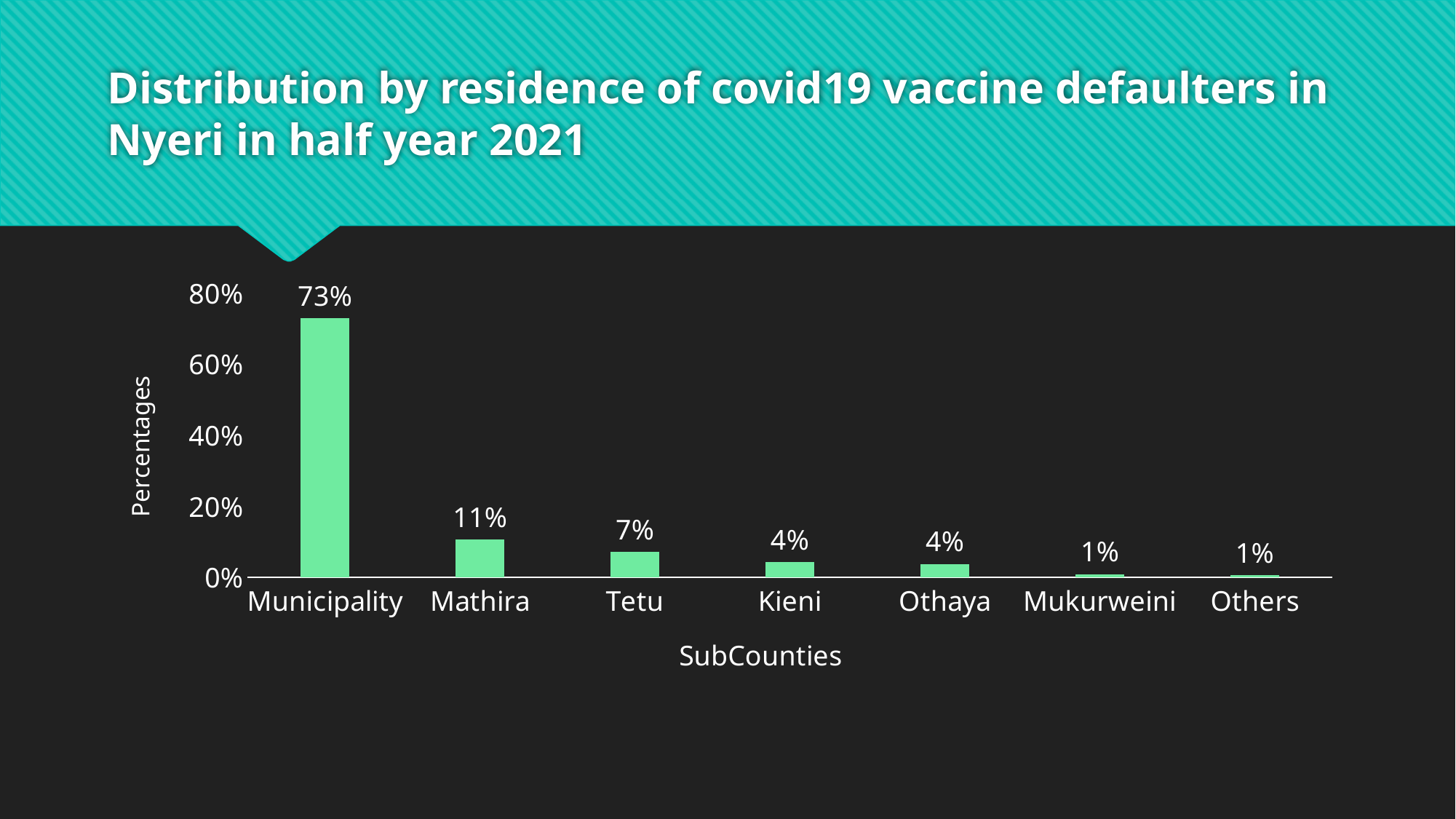
What is the difference between the values for Municipality and Mathira? 62% What percentage is shown for Tetu? 7% What kind of chart is shown on the slide? Bar chart What percentage of covid19 vaccine defaulters were from Municipality? 73% What is the value shown for Mathira? 11% What is the value for Kieni? 4% What is the label of the x axis? SubCounties What is the difference between the values for Mathira and Tetu? 4% How many sub-county categories are shown on the x axis? 7 Is the value for Municipality greater or less than 60%? greater Which is larger, the value for Tetu or the value for Othaya? Tetu Which sub-county has the highest percentage of vaccine defaulters? Municipality